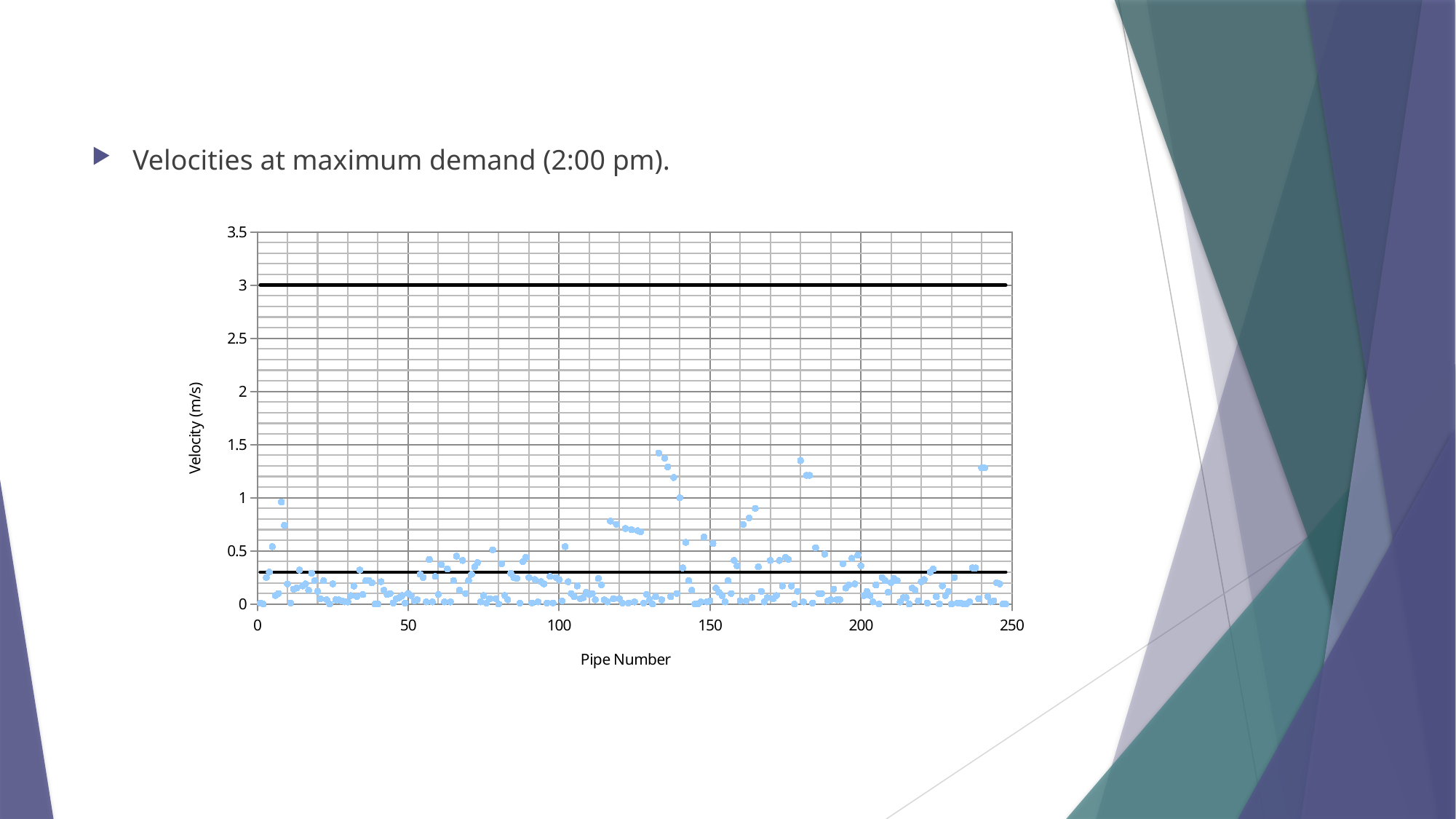
Is the lower horizontal reference line greater or less than 0.5 m/s? less Is the highest plotted velocity point greater or less than 1 m/s? greater Are any of the plotted velocity points greater than 2 m/s? No At what velocity value does the thick upper horizontal line sit on the chart? 3 What is the title of the horizontal axis of the chart? Pipe Number What kind of chart is shown on the slide? Scatter chart What is the maximum value shown on the vertical axis? 3.5 What is the maximum value shown on the horizontal axis? 250 What is the title of the vertical axis of the chart? Velocity (m/s)